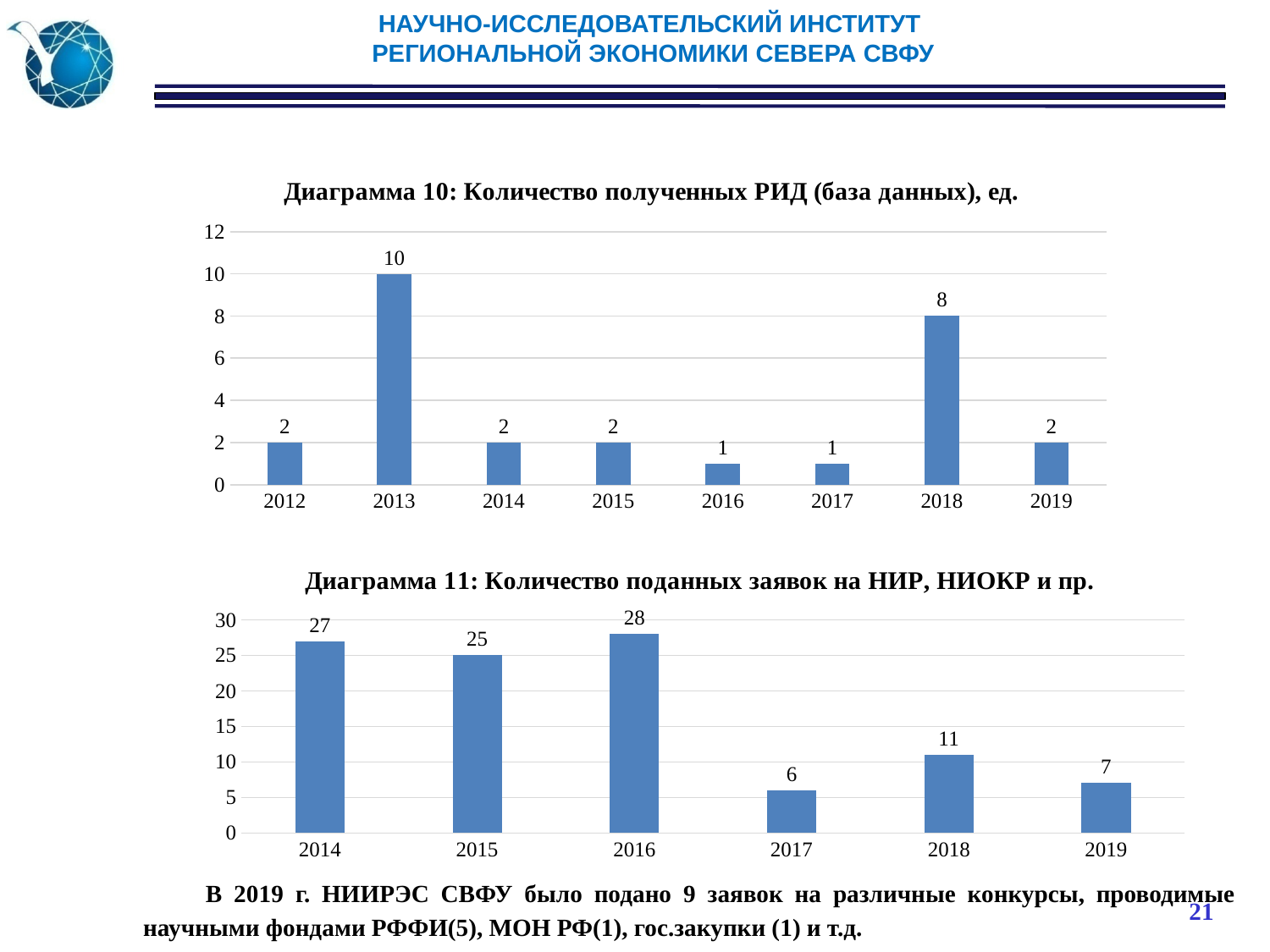
In the chart 'Диаграмма 11: Количество поданных заявок на НИР, НИОКР и пр.', which year has the lowest value? 2017 In the chart 'Диаграмма 10: Количество полученных РИД (база данных), ед.', what is the value for 2013? 10 In the chart 'Диаграмма 10: Количество полученных РИД (база данных), ед.', which year has the highest value? 2013 What kind of chart is 'Диаграмма 11: Количество поданных заявок на НИР, НИОКР и пр.'? Bar chart In the chart 'Диаграмма 10: Количество полученных РИД (база данных), ед.', what is the difference between the values for 2013 and 2018? 2 In the chart 'Диаграмма 11: Количество поданных заявок на НИР, НИОКР и пр.', what is the difference between the values for 2016 and 2017? 22 In the chart 'Диаграмма 11: Количество поданных заявок на НИР, НИОКР и пр.', which is larger, the value for 2014 or the value for 2015? 2014 In the chart 'Диаграмма 10: Количество полученных РИД (база данных), ед.', what is the value for 2016? 1 In the chart 'Диаграмма 11: Количество поданных заявок на НИР, НИОКР и пр.', what is the value for 2018? 11 In the chart 'Диаграмма 11: Количество поданных заявок на НИР, НИОКР и пр.', how many years are shown on the x axis? 6 In the chart 'Диаграмма 10: Количество полученных РИД (база данных), ед.', how many years are shown on the x axis? 8 In the chart 'Диаграмма 11: Количество поданных заявок на НИР, НИОКР и пр.', what is the value for 2016? 28